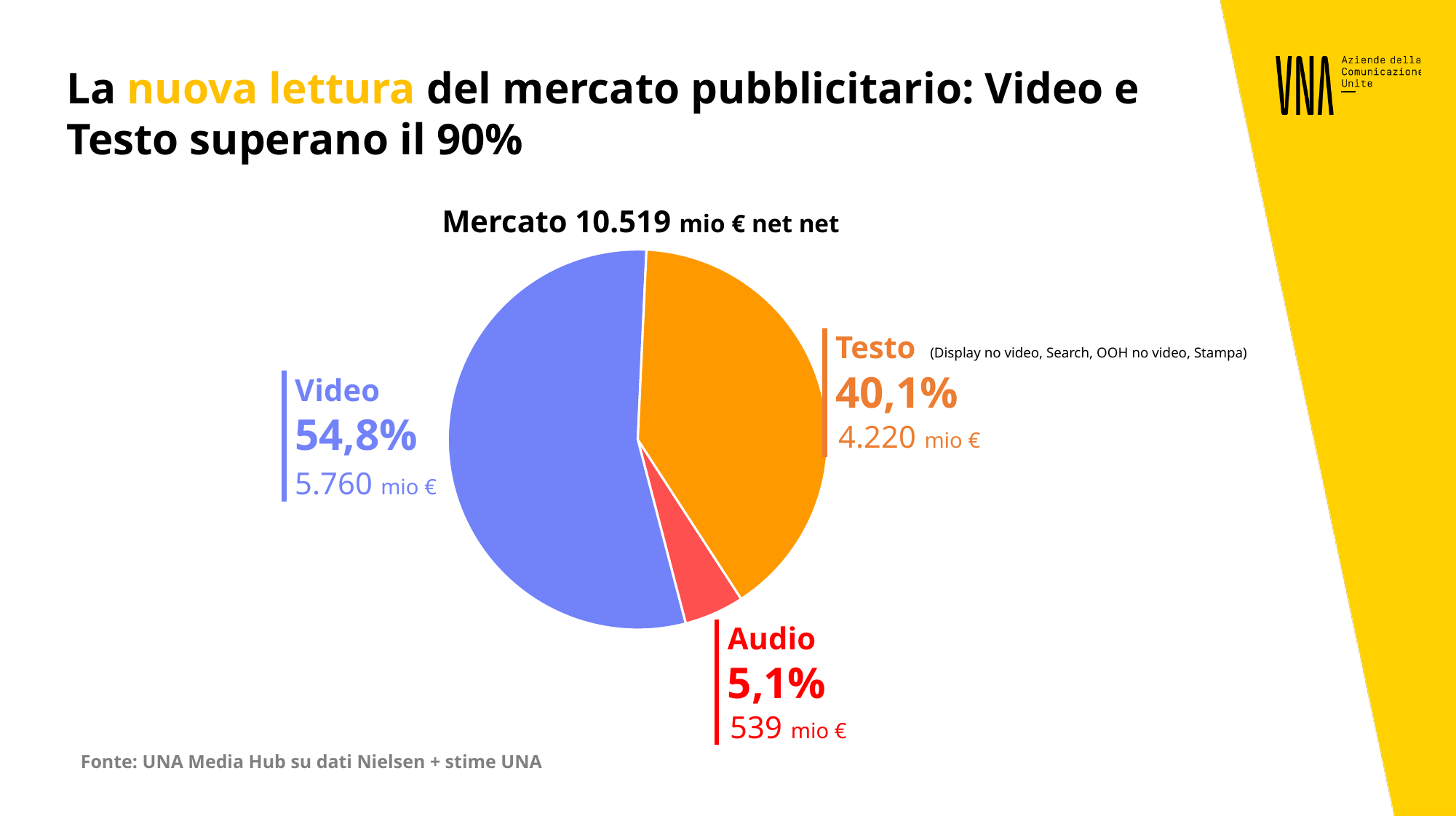
What share of the pie does Video represent? 54,8% Which category has the largest slice of the pie? Video What share of the pie does Testo represent? 40,1% What is the value in mio € shown for Testo? 4.220 mio € What share of the pie does Audio represent? 5,1% How many slices does the pie chart have? 3 What is the value in mio € shown for Video? 5.760 mio € What kind of chart is shown on the slide? pie chart What is the value in mio € shown for Audio? 539 mio € What total market value is stated in the chart title? 10.519 mio € net net What is the difference in percentage points between the Video and Testo shares? 14,7 Which category has the smallest slice of the pie? Audio